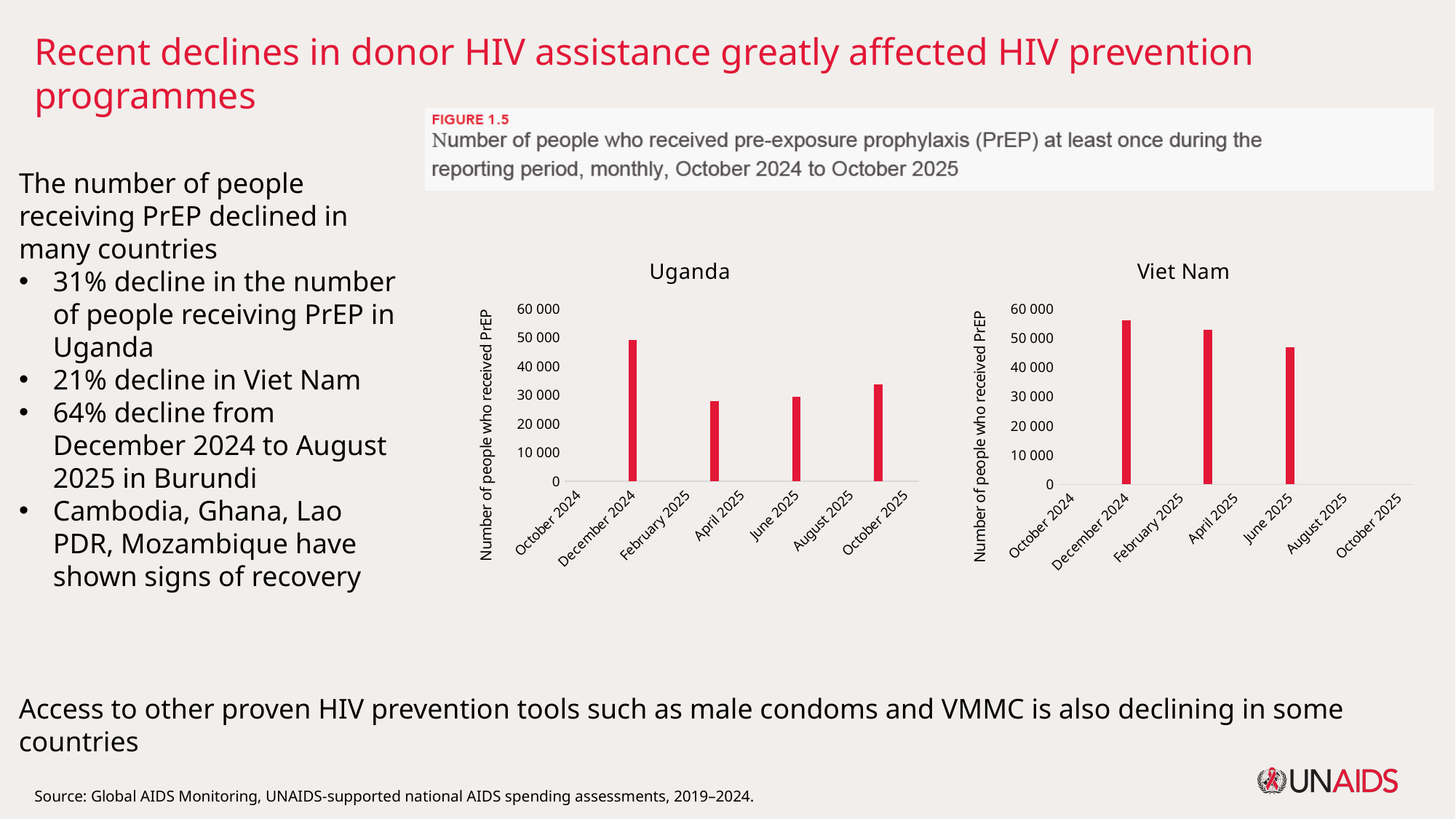
In the Viet Nam chart, is the value for June 2025 greater or less than 50 000? less How many bars are plotted in the Viet Nam chart? 3 In the Viet Nam chart, is the value for December 2024 greater or less than 50 000? greater What is the y-axis label of the Uganda chart? Number of people who received PrEP In the Uganda chart, is the value for June 2025 greater or less than 40 000? less In the Uganda chart, which month has the highest number of people who received PrEP? December 2024 What kind of chart is the Uganda chart? bar chart In the Viet Nam chart, do the values rise or fall from December 2024 to June 2025? fall Which is larger: the December 2024 value in the Viet Nam chart or the December 2024 value in the Uganda chart? Viet Nam How many bars are plotted in the Uganda chart? 4 In the Viet Nam chart, which month has the lowest number of people who received PrEP? June 2025